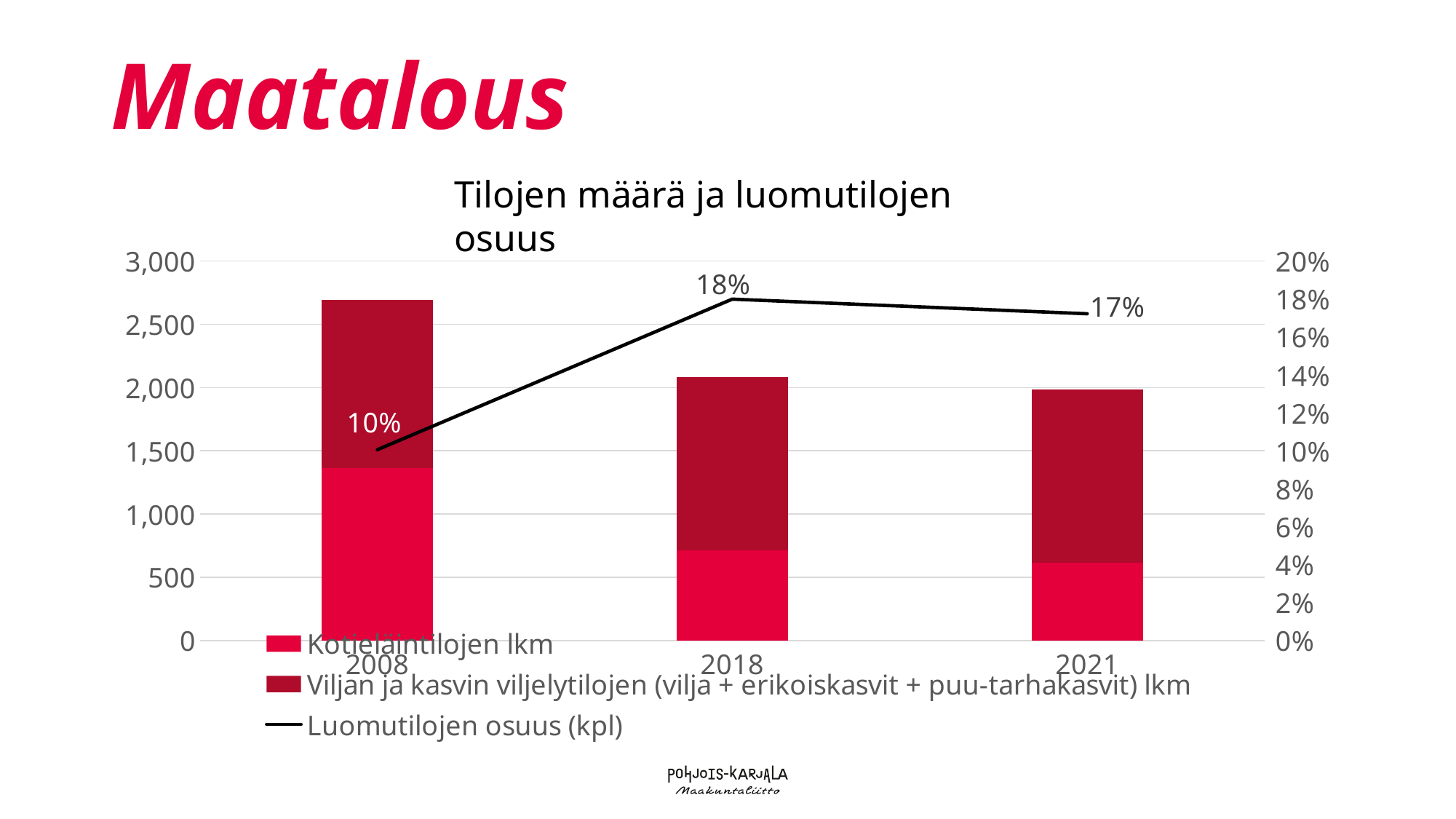
In which year is Luomutilojen osuus (kpl) highest? 2018 What is the value of Luomutilojen osuus (kpl) for 2021? 17% Is the total height of the stacked bar for 2008 greater or less than 2,500? greater In which year is Luomutilojen osuus (kpl) lowest? 2008 Is the value of Kotieläintilojen lkm for 2021 greater or less than 1,000? less What is the title of the chart? Tilojen määrä ja luomutilojen osuus How many years are shown on the x axis? 3 By how many percentage points did Luomutilojen osuus (kpl) change from 2008 to 2018? 8 percentage points What is the value of Luomutilojen osuus (kpl) for 2018? 18% Which year has a larger Luomutilojen osuus (kpl), 2008 or 2021? 2021 How many series does the legend list? 3 What is the value of Luomutilojen osuus (kpl) for 2008? 10%